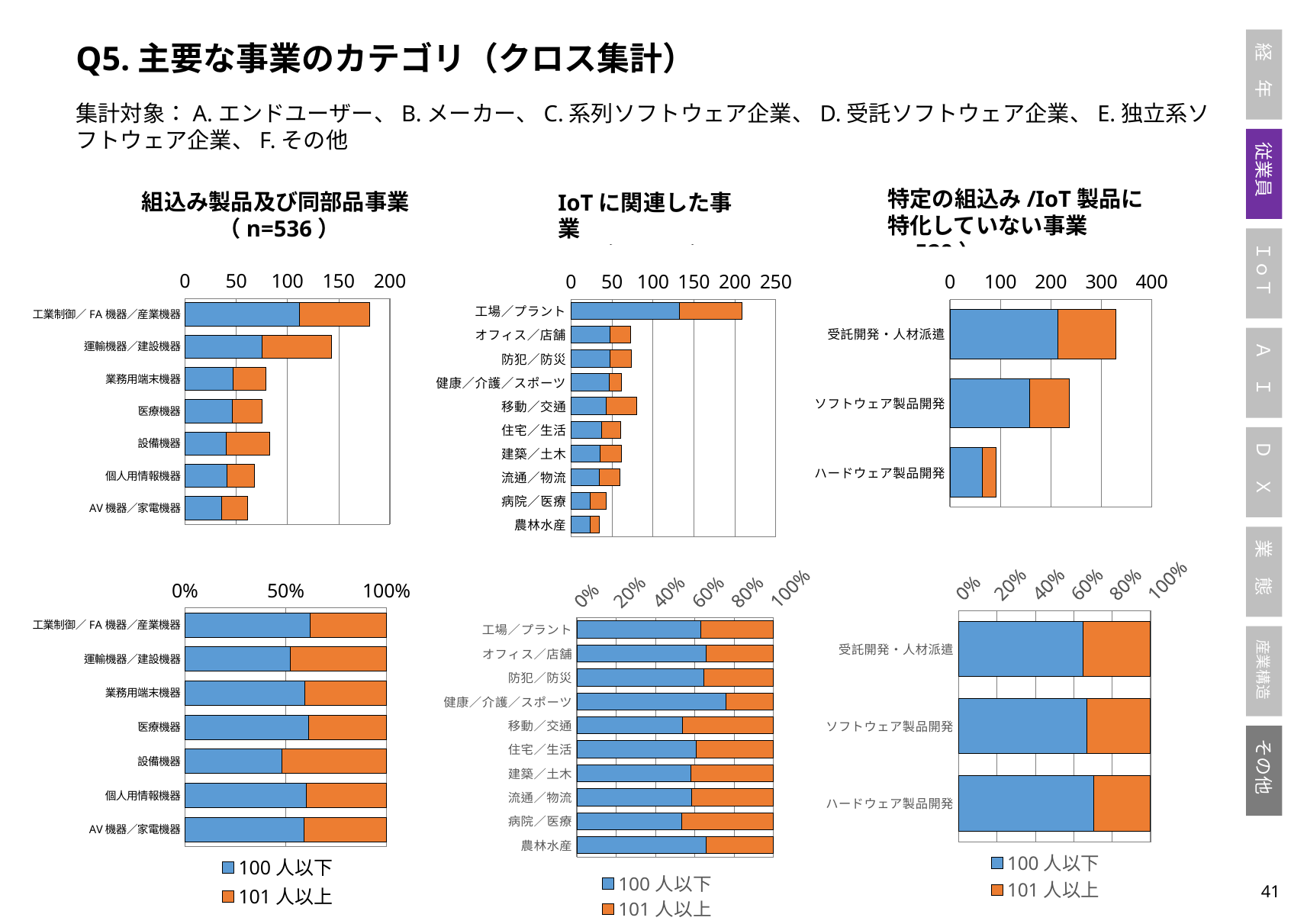
In the bottom-right chart, is the 100人以下 share for ハードウェア製品開発 greater or less than 60%? greater In the top-left chart titled 組込み製品及び同部品事業 (n=536), which has the larger total bar, 運輸機器／建設機器 or 設備機器? 運輸機器／建設機器 How many series does the legend of the bottom-left chart list? 2 How many categories are shown in the top-right chart titled 特定の組込み/IoT製品に特化していない事業? 3 In the top-middle chart titled IoTに関連した事業, which category has the longest total bar? 工場／プラント In the top-left chart titled 組込み製品及び同部品事業 (n=536), is the total value for 工業制御／FA機器／産業機器 greater or less than 150? greater In the top-middle chart titled IoTに関連した事業, which category has the shortest total bar? 農林水産 In the top-left chart titled 組込み製品及び同部品事業 (n=536), which category has the longest total bar? 工業制御／FA機器／産業機器 How many categories are shown in the top-middle chart titled IoTに関連した事業? 10 How many categories are shown in the top-left chart titled 組込み製品及び同部品事業 (n=536)? 7 What kind of chart is the top-left chart titled 組込み製品及び同部品事業 (n=536)? bar chart In the top-right chart titled 特定の組込み/IoT製品に特化していない事業, which category has the shortest total bar? ハードウェア製品開発